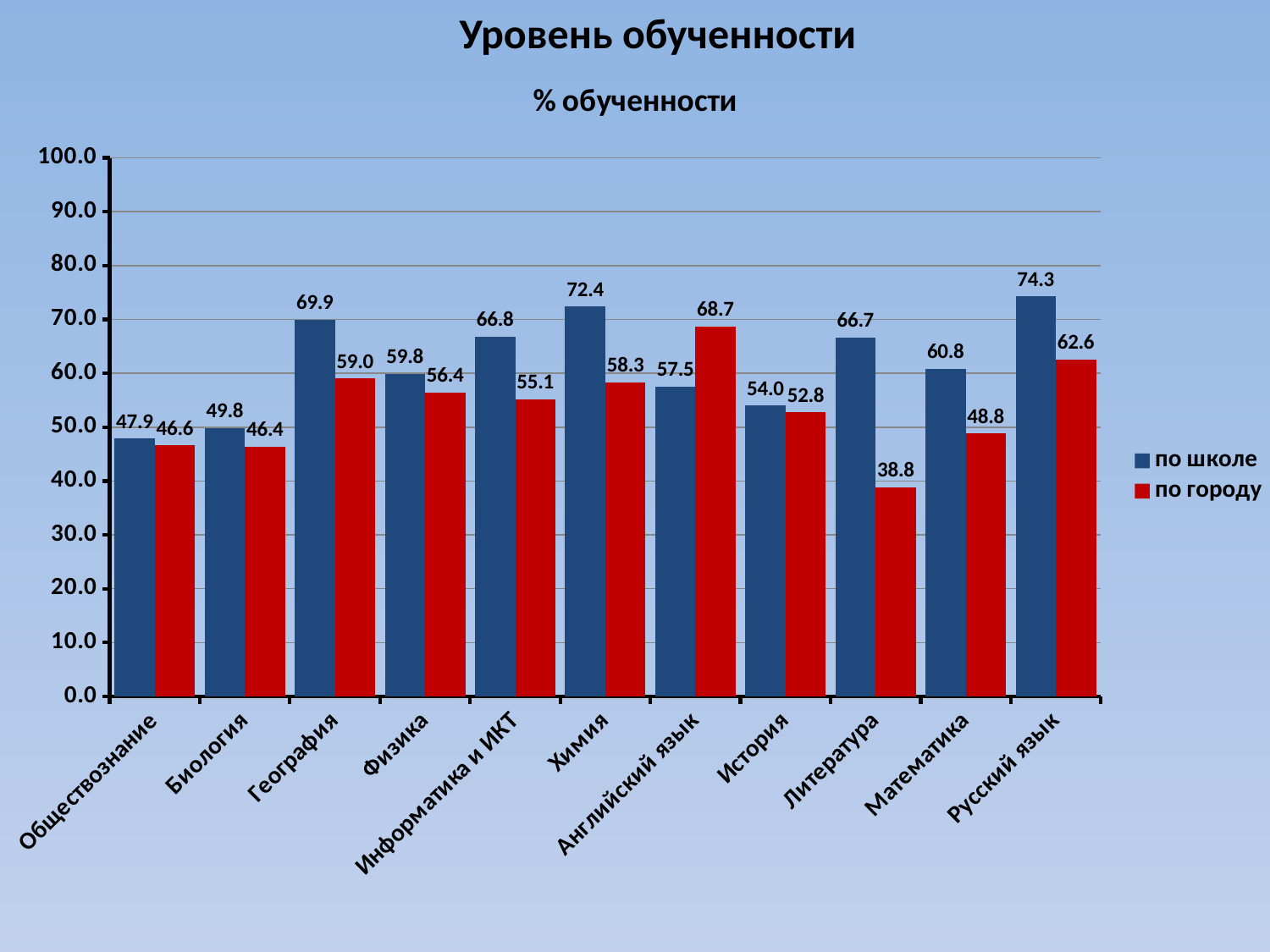
Which category has the highest value in the по школе series? Русский язык What kind of chart is shown on the slide? bar chart For Английский язык, which is larger: the по школе value or the по городу value? по городу How many series does the legend list? 2 What is the difference between the по школе and по городу values for Литература? 27.9 What is the value for Химия in the по школе series? 72.4 Which category has the lowest value in the по городу series? Литература What is the title of the chart? % обученности Is the value for Математика in the по городу series greater or less than 50.0? less How many categories are shown on the x axis? 11 What is the value for Английский язык in the по городу series? 68.7 What is the value for Литература in the по городу series? 38.8